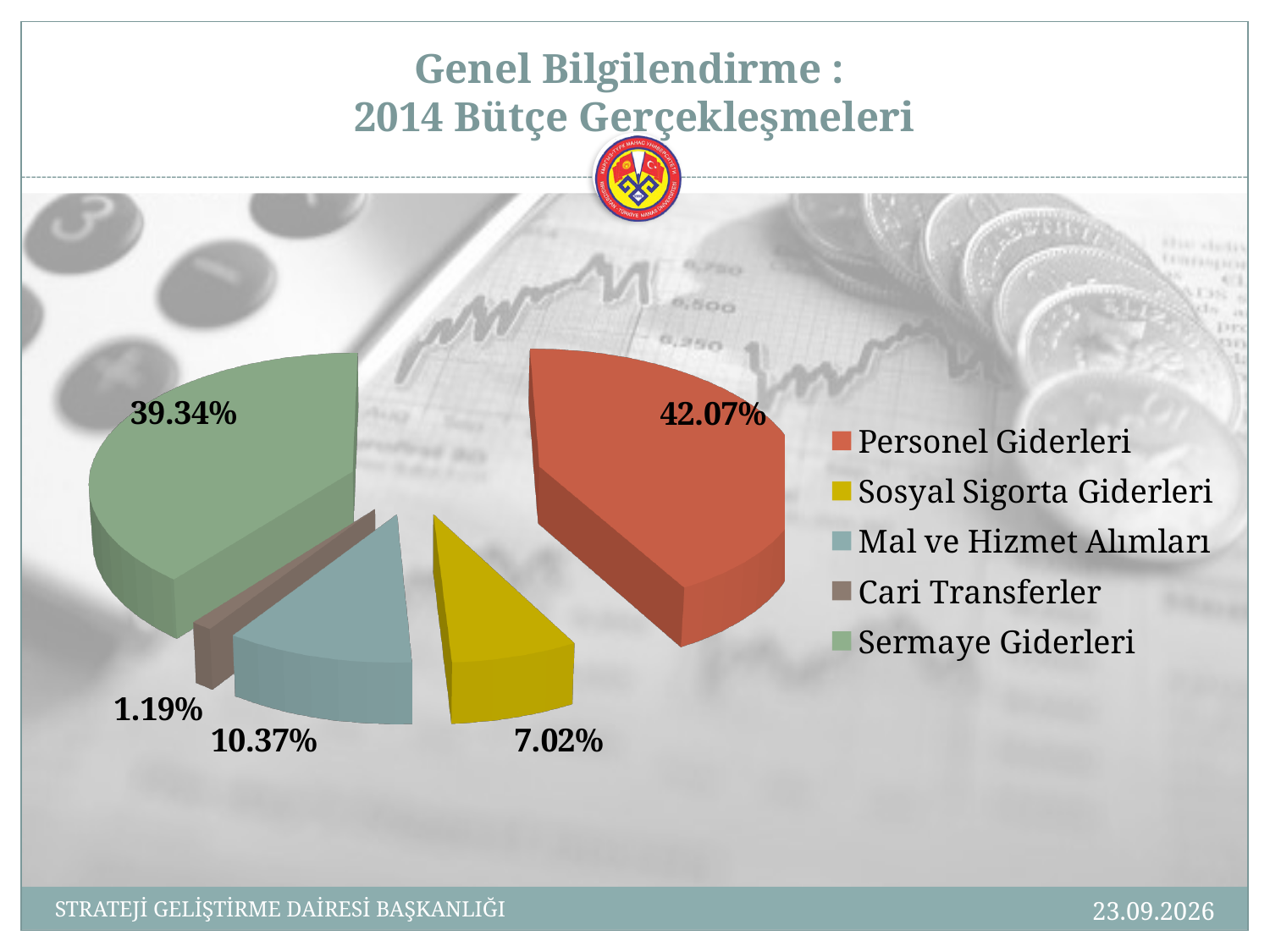
What is the share for Personel Giderleri? 42.07% What kind of chart is shown on the slide? Pie chart What is the share for Mal ve Hizmet Alımları? 10.37% Which category has the largest share of the pie? Personel Giderleri What is the difference in percentage points between Personel Giderleri and Sermaye Giderleri? 2.73 What is the share for Sosyal Sigorta Giderleri? 7.02% Which is larger, Mal ve Hizmet Alımları or Sosyal Sigorta Giderleri? Mal ve Hizmet Alımları Which category has the smallest share of the pie? Cari Transferler What is the share for Cari Transferler? 1.19% What colour is the slice for Sermaye Giderleri? Green How many categories does the legend list? 5 What is the share for Sermaye Giderleri? 39.34%